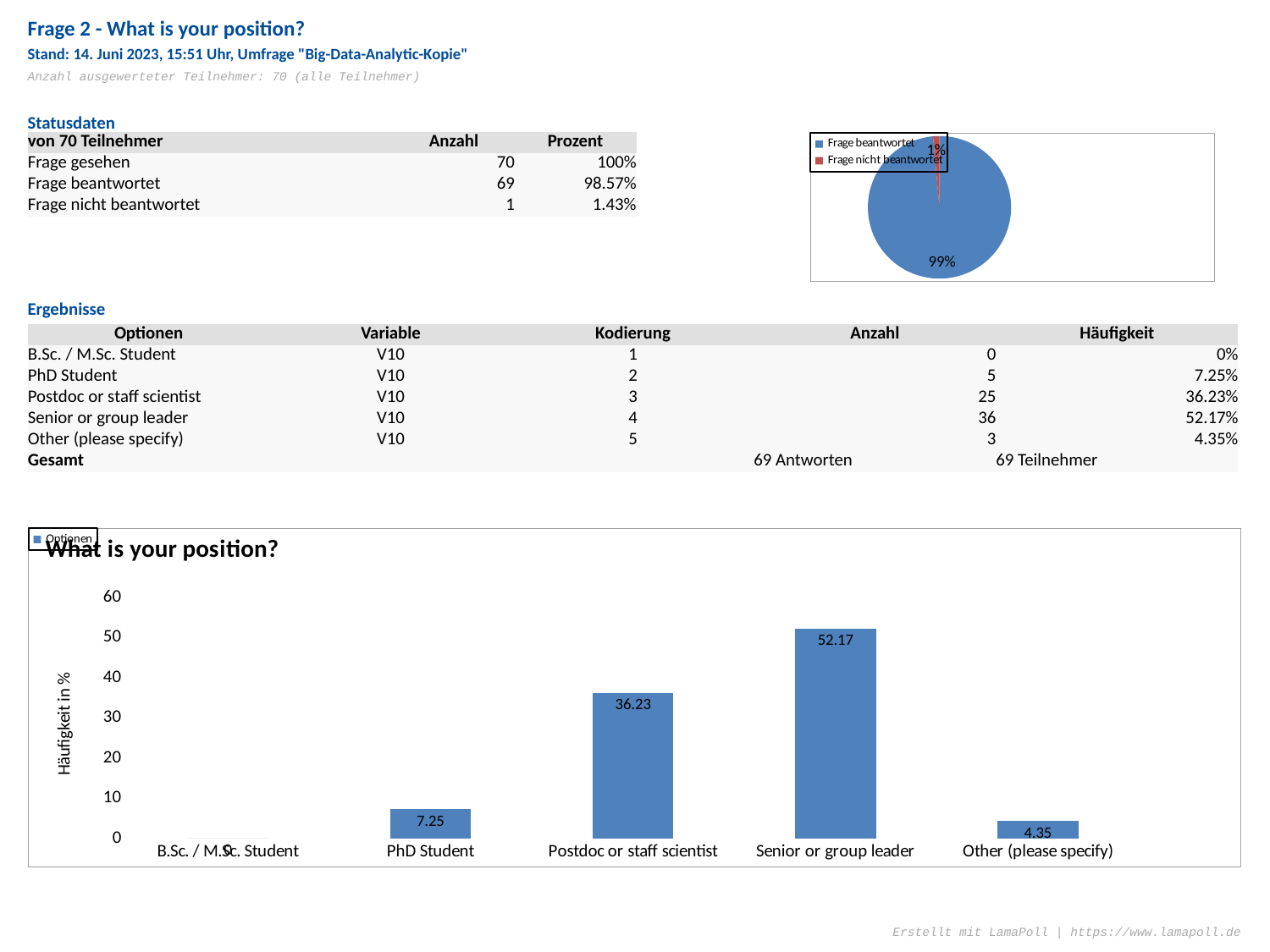
What kind of chart is the chart titled 'What is your position?'? bar chart How many categories are shown on the x axis of the bar chart 'What is your position?'? 5 In the bar chart 'What is your position?', what is the value for Senior or group leader? 52.17 In the bar chart 'What is your position?', which category has the highest value? Senior or group leader In the bar chart 'What is your position?', which category has the lowest value? B.Sc. / M.Sc. Student In the pie chart at the top right of the slide, what share is shown for Frage beantwortet? 99% In the bar chart 'What is your position?', which is larger: the value for PhD Student or the value for Other (please specify)? PhD Student How many entries does the legend of the pie chart at the top right of the slide list? 2 In the bar chart 'What is your position?', what is the difference between the values for Senior or group leader and Postdoc or staff scientist? 15.94 In the bar chart 'What is your position?', what is the value for Postdoc or staff scientist? 36.23 In the bar chart 'What is your position?', what is the value for PhD Student? 7.25 In the bar chart 'What is your position?', is the value for Postdoc or staff scientist greater or less than 30? greater